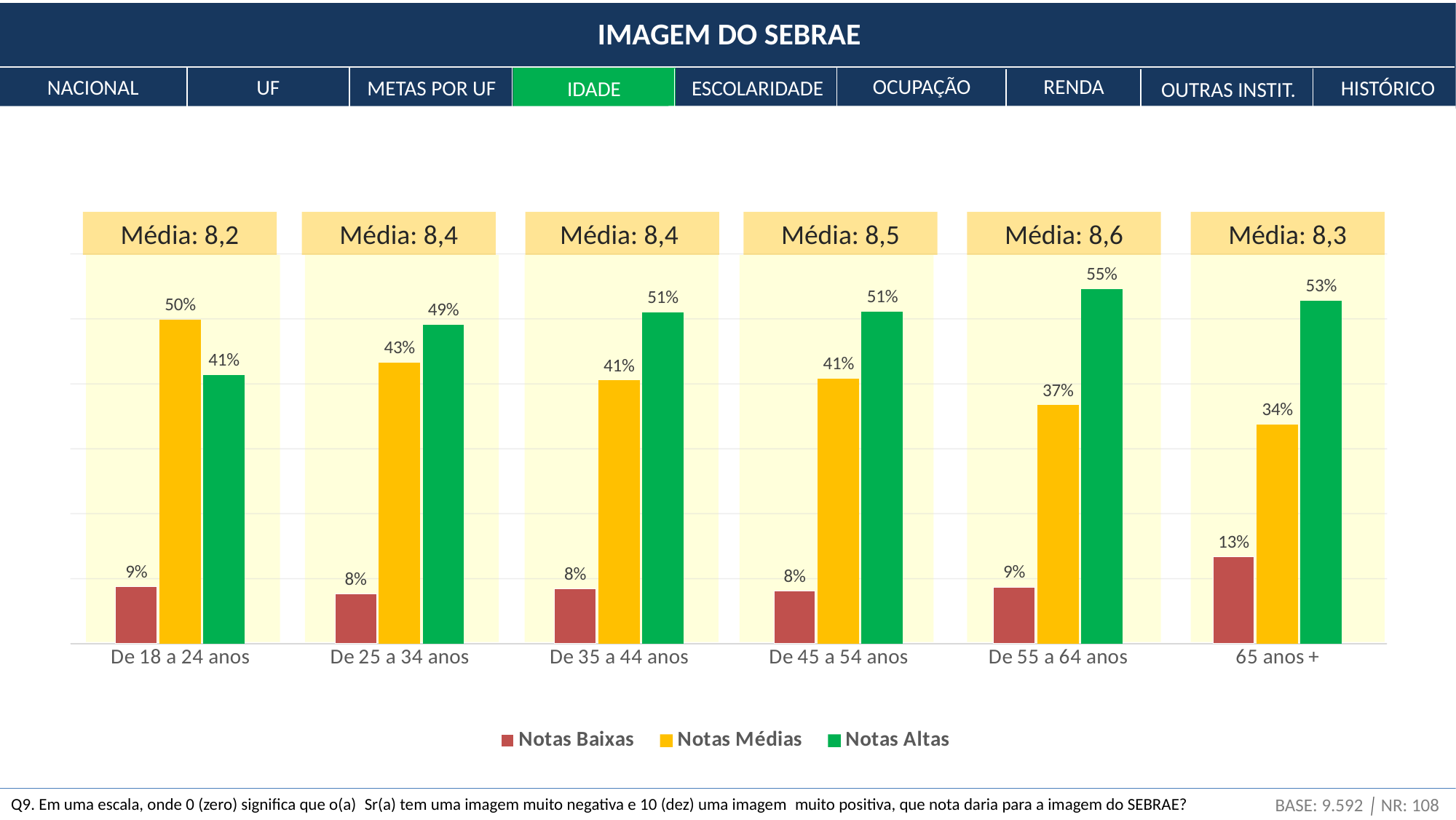
Which is larger for De 18 a 24 anos: Notas Médias or Notas Altas? Notas Médias What is the value of Notas Baixas for 65 anos +? 13% What is the value of Notas Altas for De 55 a 64 anos? 55% How many series does the legend list? 3 Which age group has the lowest value for Notas Médias? 65 anos + What is the Média shown above the De 45 a 54 anos group? 8,5 How many age groups are shown on the x axis? 6 What is the difference between Notas Altas and Notas Médias for De 55 a 64 anos? 18% Which age group has the highest value for Notas Altas? De 55 a 64 anos What is the value of Notas Médias for De 18 a 24 anos? 50% Which colour represents Notas Baixas in the legend? Red What kind of chart is shown on the slide? Bar chart